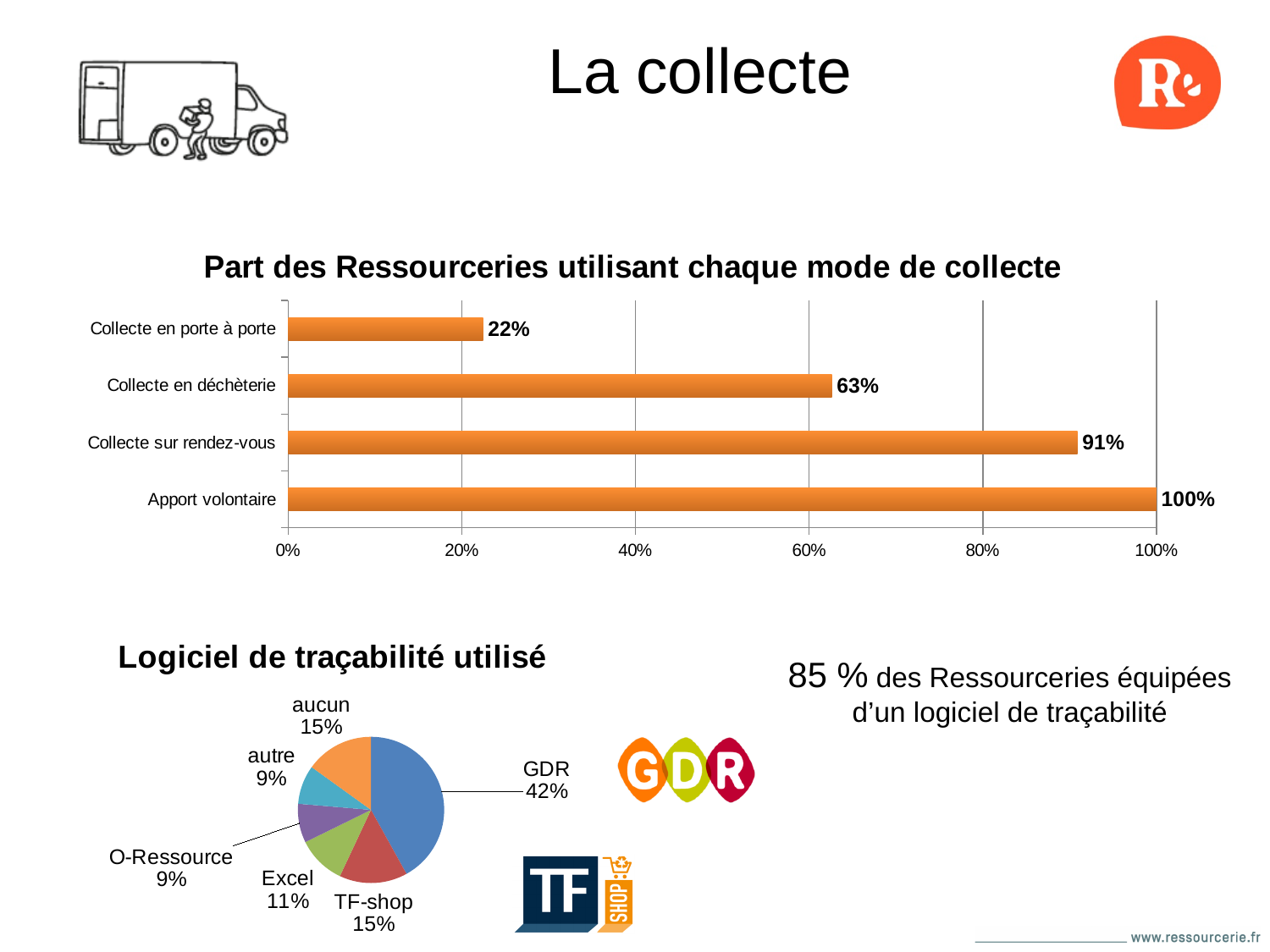
In the chart 'Part des Ressourceries utilisant chaque mode de collecte', which collection mode has the highest share? Apport volontaire In the chart 'Logiciel de traçabilité utilisé', which slice is the largest? GDR What kind of chart is 'Part des Ressourceries utilisant chaque mode de collecte'? Bar chart In the chart 'Logiciel de traçabilité utilisé', what share does GDR have? 42% In the chart 'Part des Ressourceries utilisant chaque mode de collecte', what is the value for Collecte en porte à porte? 22% In the chart 'Part des Ressourceries utilisant chaque mode de collecte', what is the difference between Collecte sur rendez-vous and Collecte en déchèterie? 28% In the chart 'Part des Ressourceries utilisant chaque mode de collecte', which collection mode has the lowest share? Collecte en porte à porte What kind of chart is 'Logiciel de traçabilité utilisé'? Pie chart In the chart 'Logiciel de traçabilité utilisé', how many slices does the pie have? 6 In the chart 'Part des Ressourceries utilisant chaque mode de collecte', how many collection modes are shown? 4 In the chart 'Logiciel de traçabilité utilisé', what is the value for Excel? 11% In the chart 'Part des Ressourceries utilisant chaque mode de collecte', what is the value for Collecte en déchèterie? 63%